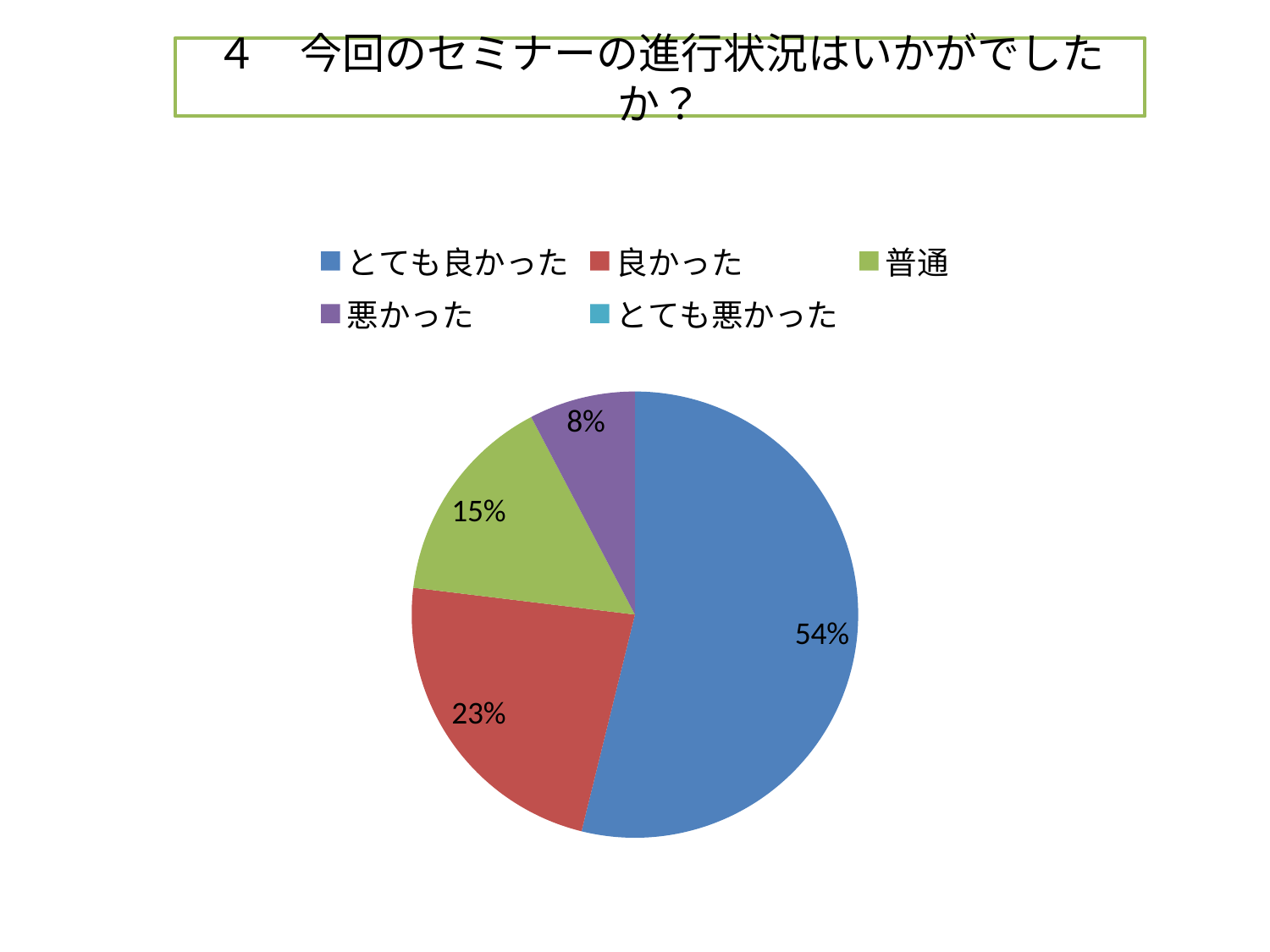
What kind of chart is shown on the slide? pie chart What colour is the slice for 普通? green Which is larger, the share for 普通 or the share for 悪かった? 普通 What share of the pie does 良かった have? 23% What share of the pie does 悪かった have? 8% Which labelled slice of the pie is the smallest? 悪かった What is the difference in percentage points between とても良かった and 良かった? 31 What share of the pie does とても良かった have? 54% What is the combined share of とても良かった and 良かった? 77% Which category has the largest slice of the pie? とても良かった How many entries does the legend list? 5 What share of the pie does 普通 have? 15%